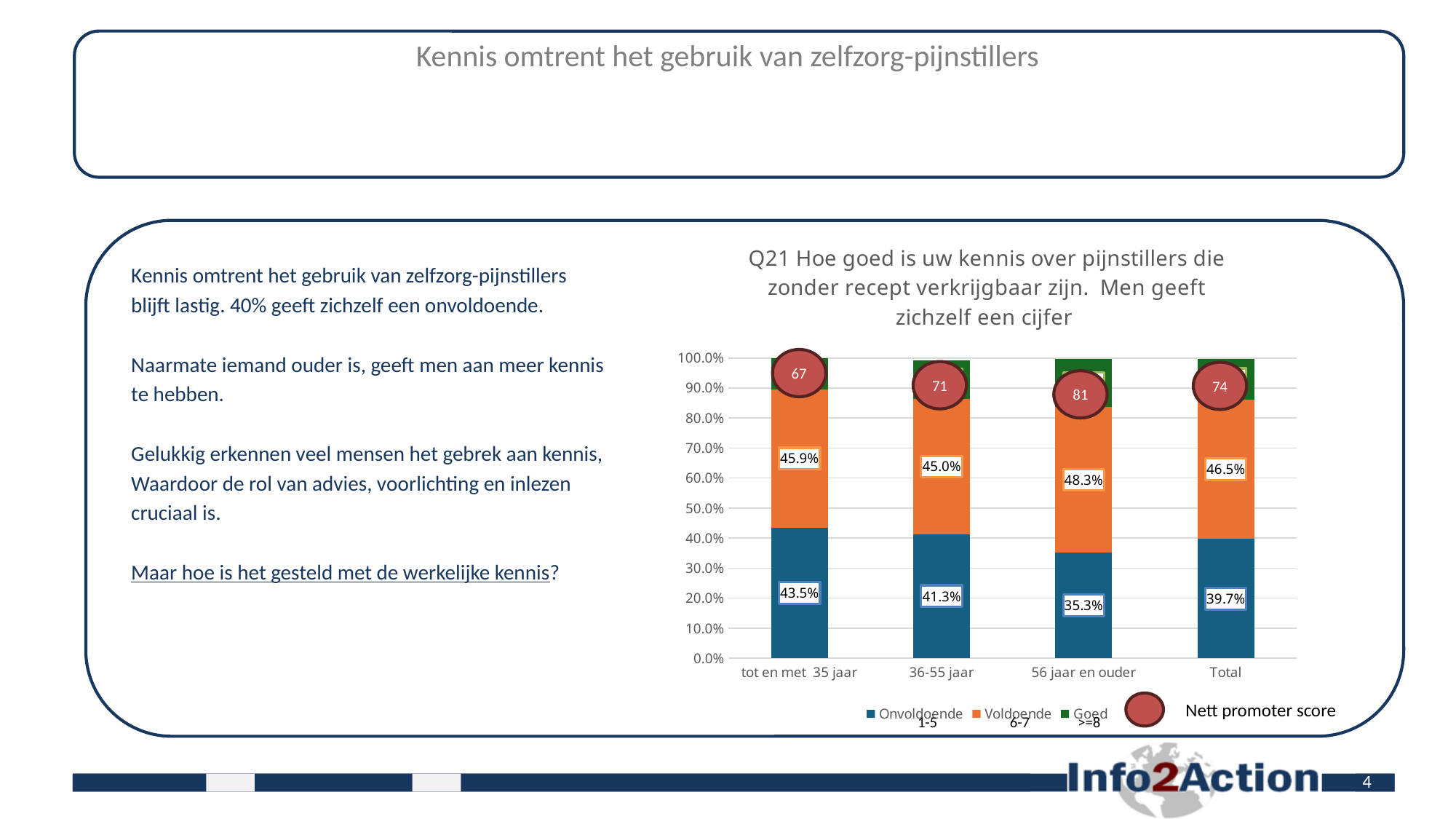
How many series does the chart legend list? 3 Which category has the lowest Onvoldoende value? 56 jaar en ouder Does the Onvoldoende value rise or fall across the three age groups from 'tot en met 35 jaar' to '56 jaar en ouder'? fall Which is larger, the Voldoende value for '36-55 jaar' or for 'Total'? Total What is the Nett promoter score shown for '56 jaar en ouder'? 81 How many categories are shown on the x axis of the chart? 4 What type of chart is shown on the slide? stacked bar chart What is the Onvoldoende value for 'tot en met 35 jaar'? 43.5% What is the difference between the Onvoldoende values for 'tot en met 35 jaar' and '56 jaar en ouder'? 8.2% What is the Onvoldoende value for 'Total'? 39.7% Which category has the highest Onvoldoende value? tot en met 35 jaar What is the Voldoende value for '56 jaar en ouder'? 48.3%